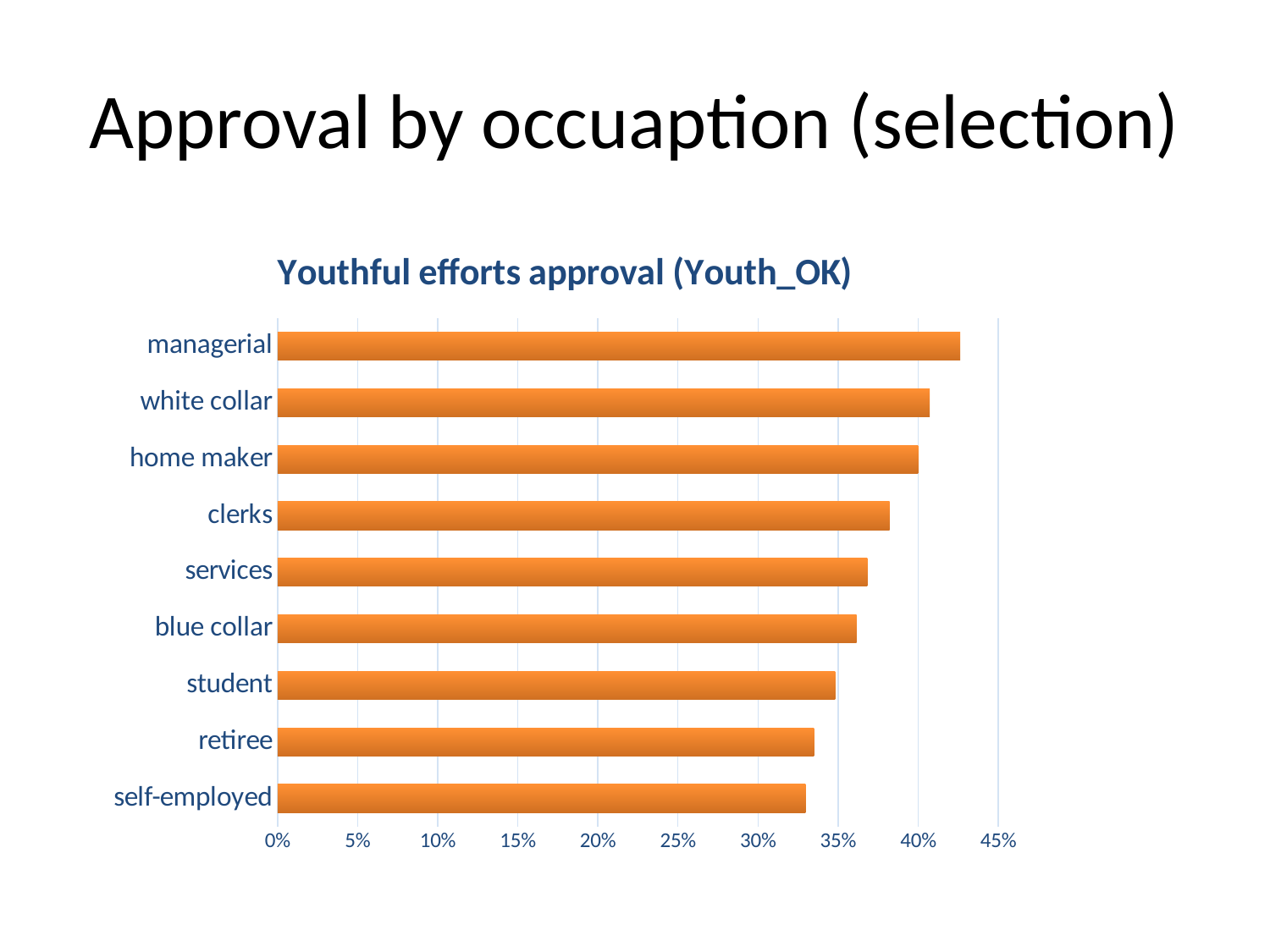
Is the value for self-employed greater or less than 35%? less How many occupation categories are plotted in the chart? 9 What is the title of the chart? Youthful efforts approval (Youth_OK) Which is larger, the value for student or the value for clerks? clerks Is the value for clerks greater or less than 40%? less Do the bars get shorter or longer going from the top category to the bottom category? shorter Is the value for managerial greater or less than 40%? greater Which is larger, the value for white collar or the value for retiree? white collar Which occupation has the highest approval value? managerial What kind of chart is shown on the slide? bar chart